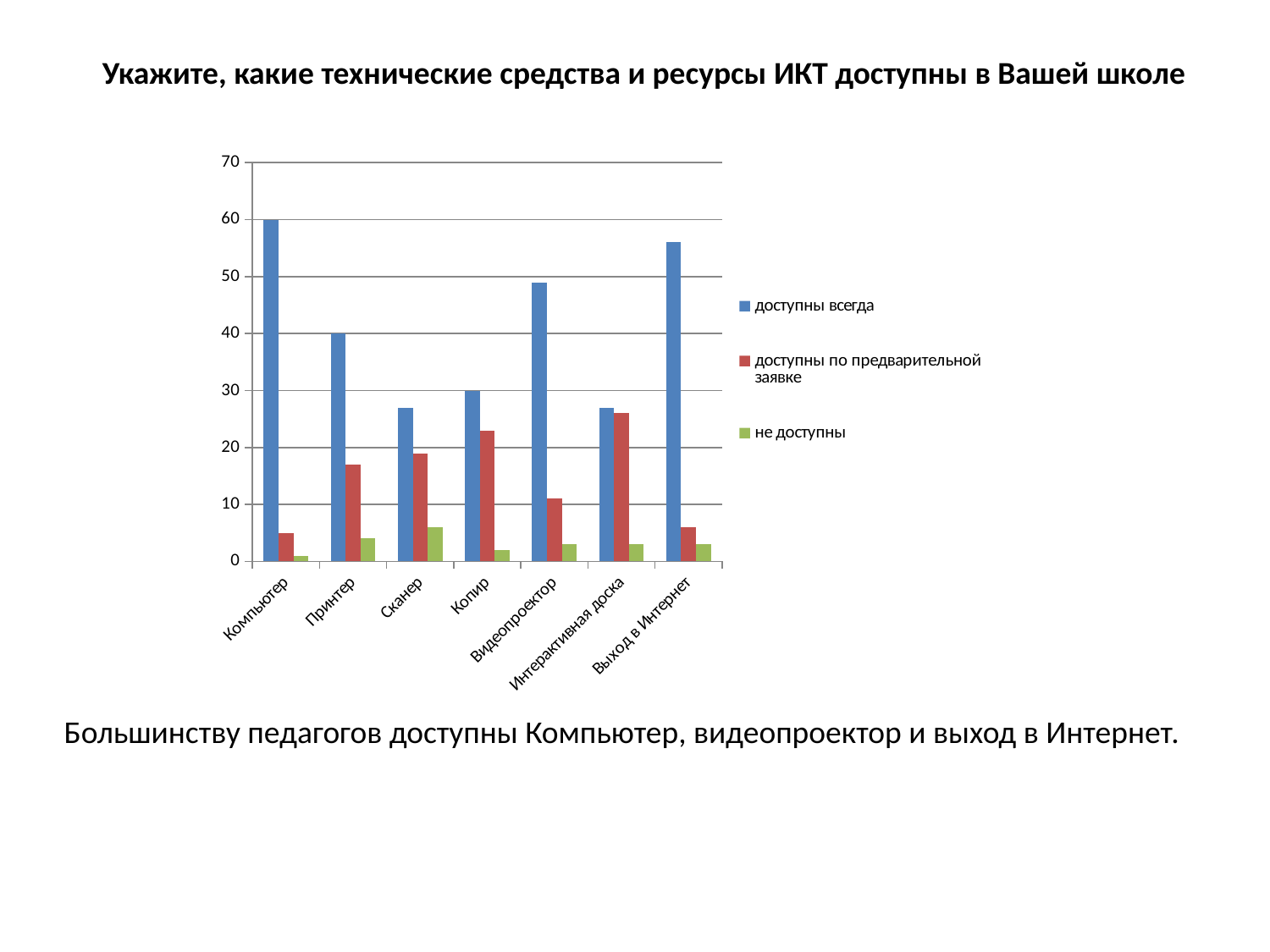
What is the value for Принтер in the series "доступны всегда"? 40 Which category has the highest value in the series "доступны всегда"? Компьютер How many series does the chart legend list? 3 What is the value for Компьютер in the series "доступны всегда"? 60 Which category has the lowest value in the series "не доступны"? Компьютер In the series "доступны всегда", which is larger: Выход в Интернет or Видеопроектор? Выход в Интернет Is the value for Видеопроектор in the series "доступны всегда" greater or less than 40? greater What kind of chart is shown on the slide? bar chart Which category has the highest value in the series "доступны по предварительной заявке"? Интерактивная доска How many categories are shown on the x axis of the chart? 7 What is the value for Копир in the series "доступны всегда"? 30 What is the title of the chart on the slide? Укажите, какие технические средства и ресурсы ИКТ доступны в Вашей школе